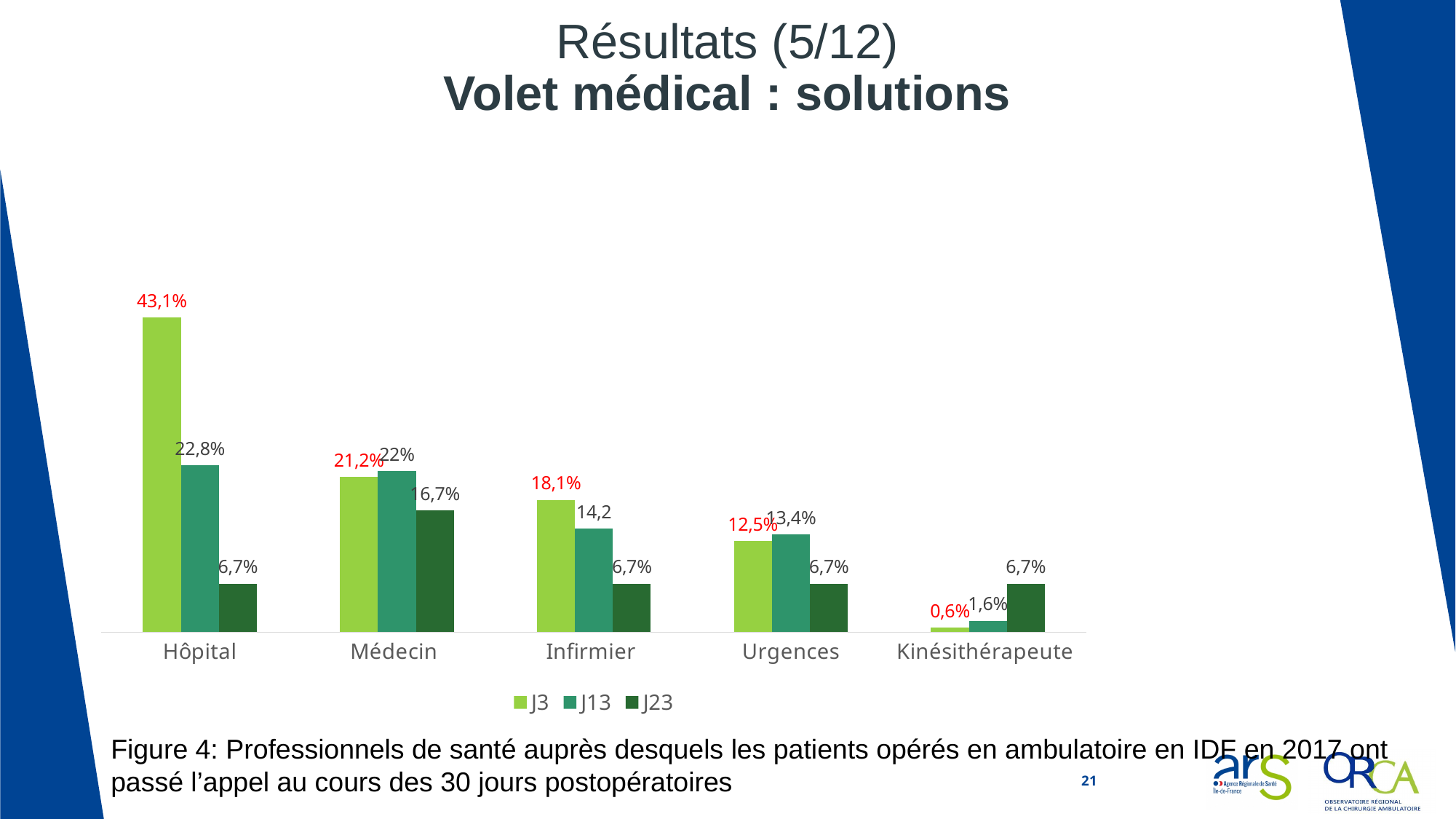
What is the J3 value for Kinésithérapeute? 0,6% For Urgences, which is larger: the J3 value or the J13 value? J13 Which series is shown in the darkest green colour? J23 What is the J23 value for Médecin? 16,7% Which category has the lowest J13 value? Kinésithérapeute What is the J3 value for Hôpital? 43,1% What kind of chart is shown on the slide? Bar chart What is the difference between the J3 and J13 values for Hôpital? 20,3% What is the J13 value for Hôpital? 22,8% How many series does the legend list? 3 Which category has the highest J3 value? Hôpital How many categories are shown on the x axis? 5